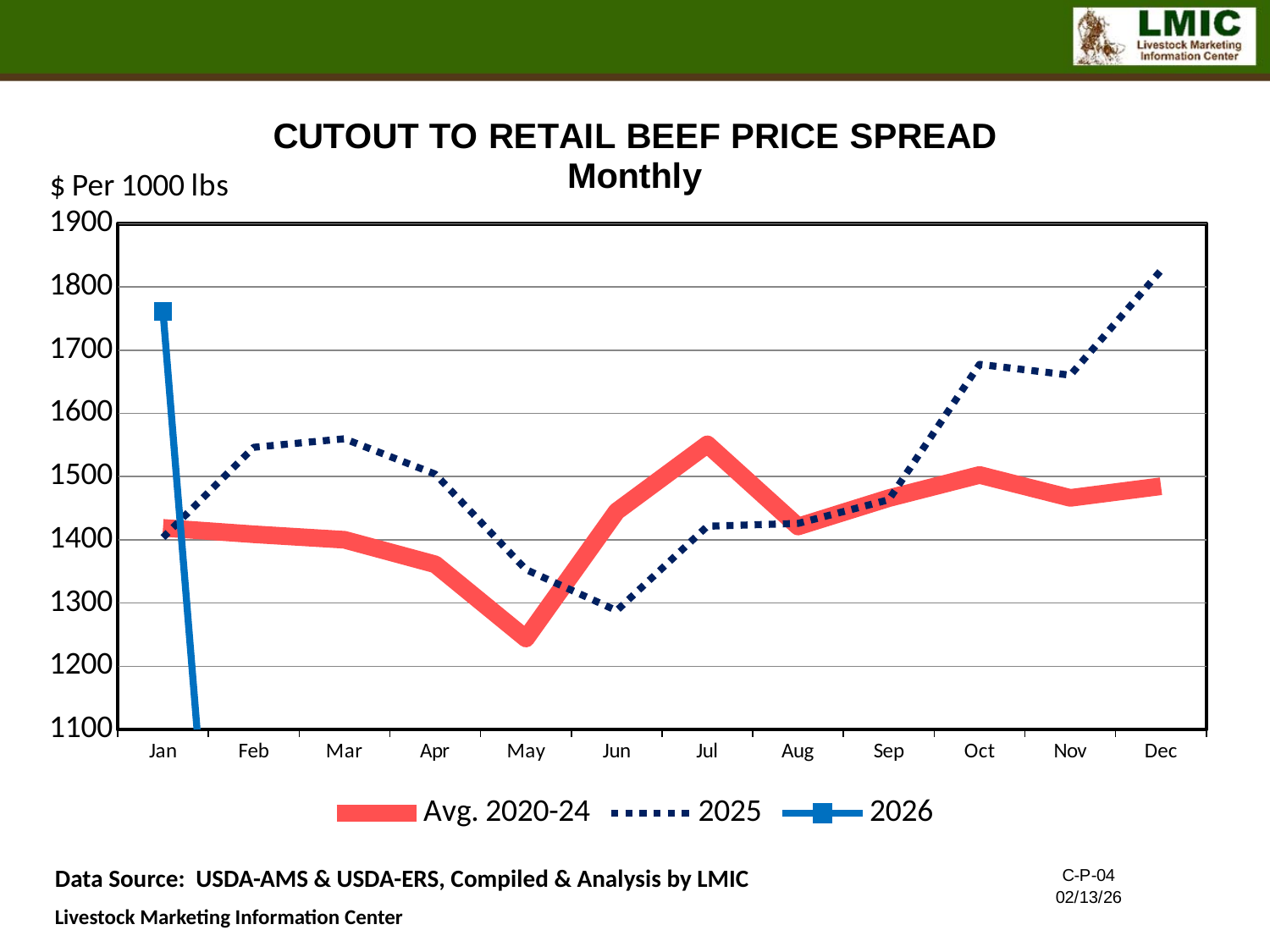
Does the 2025 series rise or fall from Sep to Dec? Rise Is the 2025 value for Dec greater or less than 1800? greater In which month does the Avg. 2020-24 series reach its lowest value? May Which series has the larger value in Jul, Avg. 2020-24 or 2025? Avg. 2020-24 In which month does the Avg. 2020-24 series reach its highest value? Jul Is the 2026 value for Jan greater or less than 1700? greater In which month does the 2025 series reach its lowest value? Jun What unit is shown on the y axis label? $ Per 1000 lbs How many months are shown along the x axis? 12 What type of chart is shown on the slide? Line chart In which month does the 2025 series reach its highest value? Dec How many series does the legend list? 3